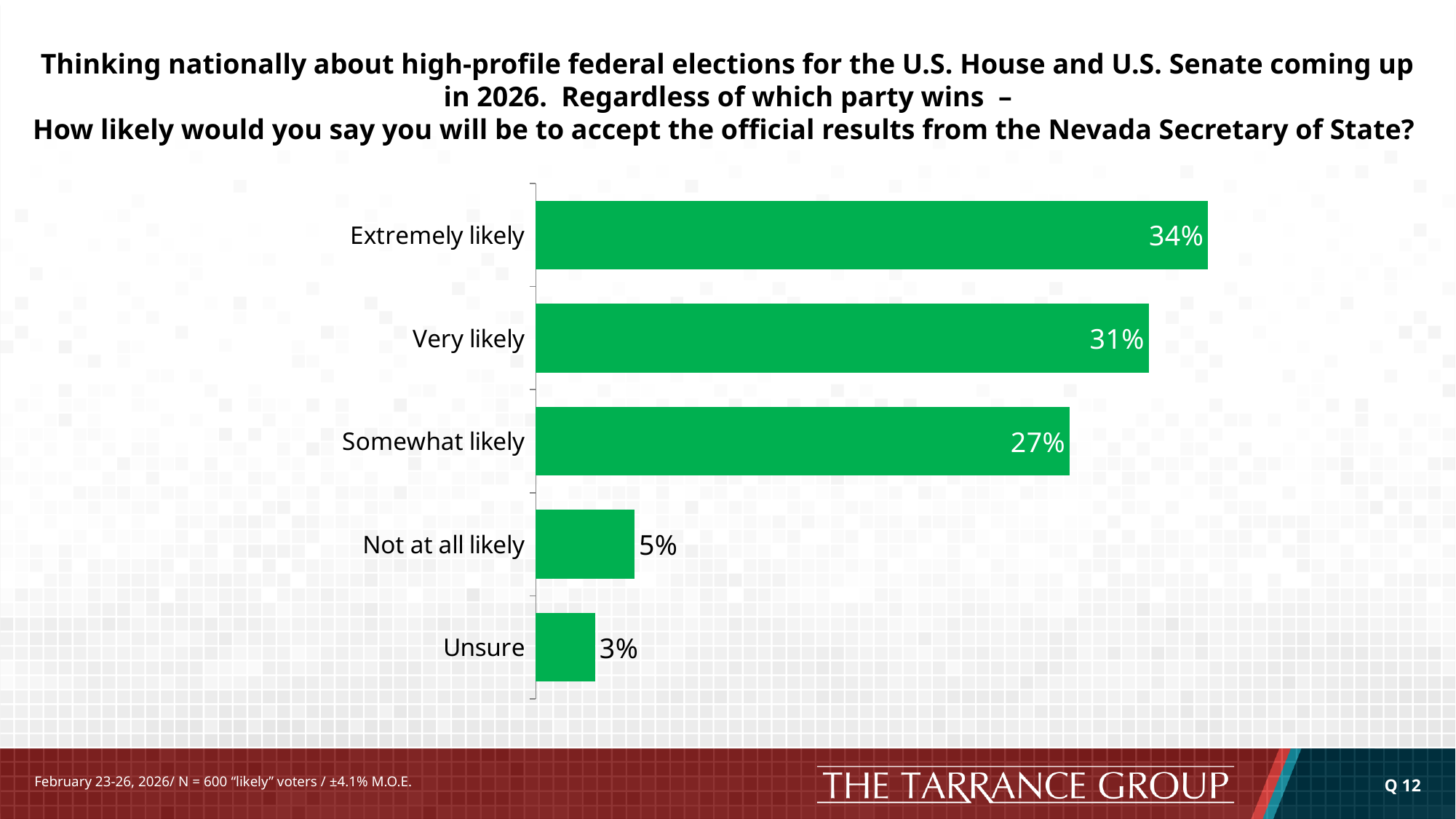
How many response categories are shown in the chart? 5 What percentage of respondents were Unsure? 3% What percentage of respondents said they are extremely likely to accept the official results? 34% What is the value shown for the Very likely category? 31% What is the difference between the Somewhat likely and Not at all likely values? 22 percentage points Which response category has the highest value? Extremely likely What is the difference between the Extremely likely and Very likely values? 3 percentage points Which is larger, the value for Very likely or the value for Somewhat likely? Very likely What is the value for Not at all likely? 5% Which response category has the lowest value? Unsure What type of chart is shown on the slide? Bar chart What percentage of respondents answered Somewhat likely? 27%